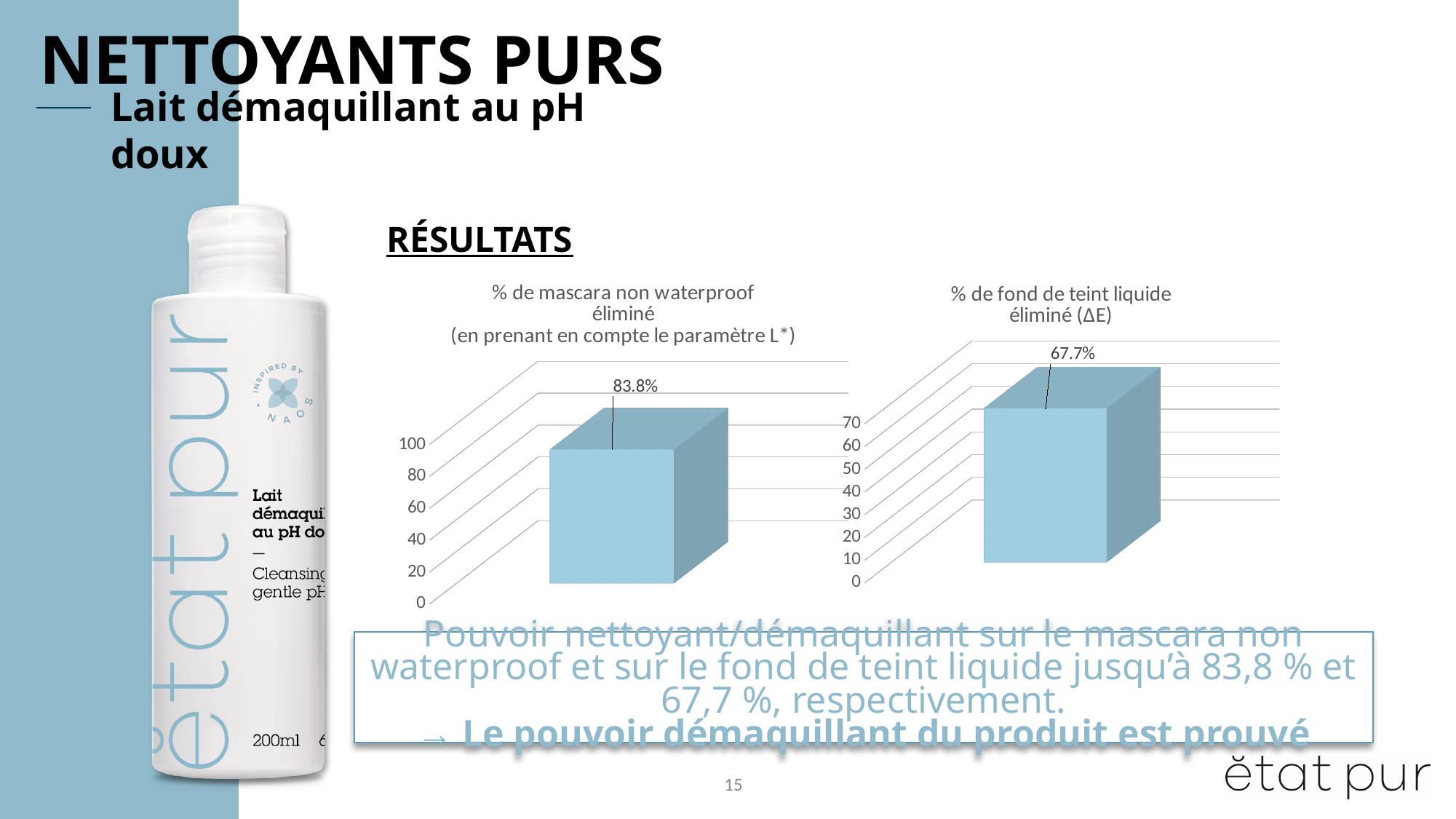
In the right chart, what percentage of liquid foundation is eliminated (ΔE)? 67.7% How many bars are plotted in the left chart? 1 What is the difference between the value in the left chart (83.8%) and the value in the right chart (67.7%)? 16.1 percentage points Which is larger: the value in the left chart (mascara non waterproof) or the value in the right chart (fond de teint liquide)? Mascara non waterproof (83.8%) In the left chart, what percentage of non-waterproof mascara is eliminated? 83.8% What is the highest tick value shown on the vertical axis of the left chart? 100 In the left chart, is the value for mascara non waterproof greater or less than 80? greater What is the title of the right chart? % de fond de teint liquide éliminé (ΔE) How many bars are plotted in the right chart? 1 What kind of chart is the right chart, '% de fond de teint liquide éliminé (ΔE)'? Bar chart What kind of chart is the left chart, '% de mascara non waterproof éliminé'? Bar chart In the right chart, is the value for fond de teint liquide greater or less than 70? less